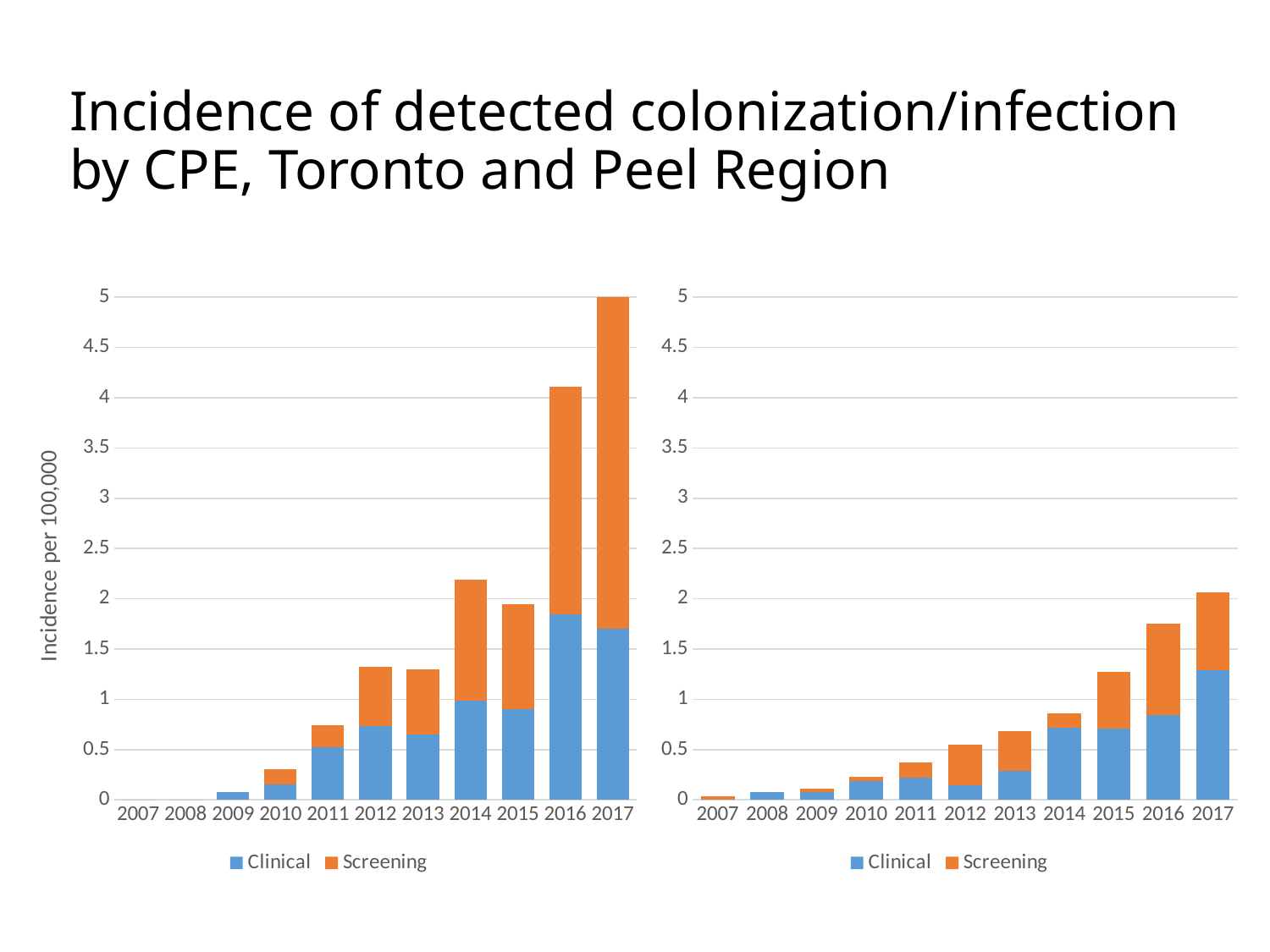
In the right chart, which year has the larger total bar, 2014 or 2015? 2015 How many years are shown along the x axis of the right chart? 11 In the left chart, do the total values generally rise or fall from 2007 to 2017? rise In the left chart, which year has the highest total bar? 2017 In the right chart, which year has the highest total bar? 2017 In the right chart, is the total value for 2017 greater or less than 1.5? greater In the left chart, is the total value for 2016 greater or less than 3.5? greater What is the label on the vertical axis of the left chart? Incidence per 100,000 In the right chart, which year has the lowest total bar? 2007 What kind of chart is shown on the left side of the slide? stacked bar chart How many series does the legend of the left chart list? 2 In the right chart, is the total value for 2016 greater or less than 2? less